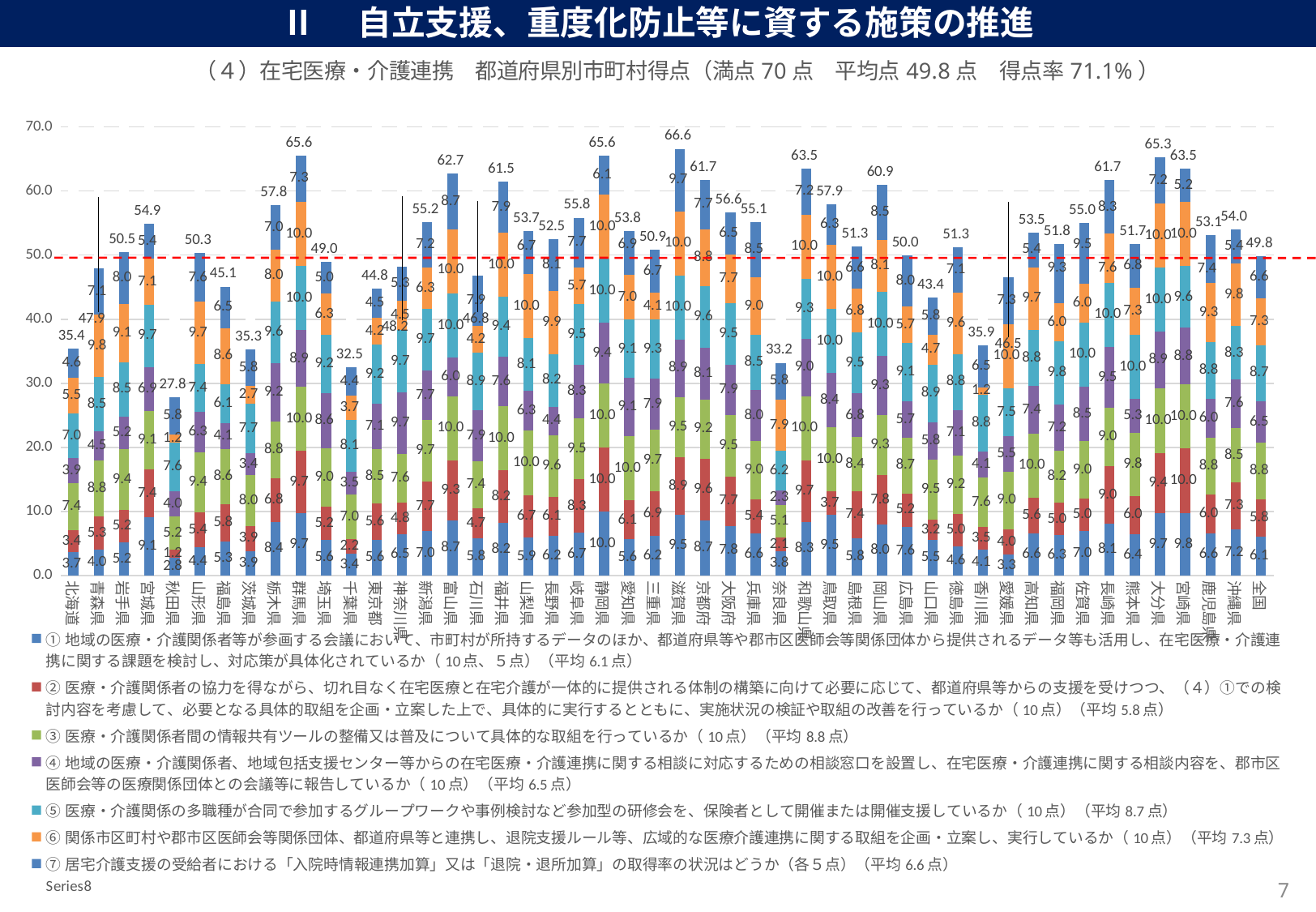
What is the total score for 大分県? 65.3 What is the total score for 全国? 49.8 Which prefecture has the lowest total score? 秋田県 What is the difference between the total score of 群馬県 and 全国? 15.8 Which prefecture has the highest total score? 滋賀県 What is the difference between the total scores of 滋賀県 and 秋田県? 38.8 What average score (平均点) is stated in the chart title? 49.8 点 What kind of chart is shown on the slide? Stacked bar chart What is the total score for 秋田県? 27.8 Is the total score for 奈良県 greater or less than 40.0? less Which has a higher total score, 富山県 or 福井県? 富山県 What is the total score for 滋賀県? 66.6